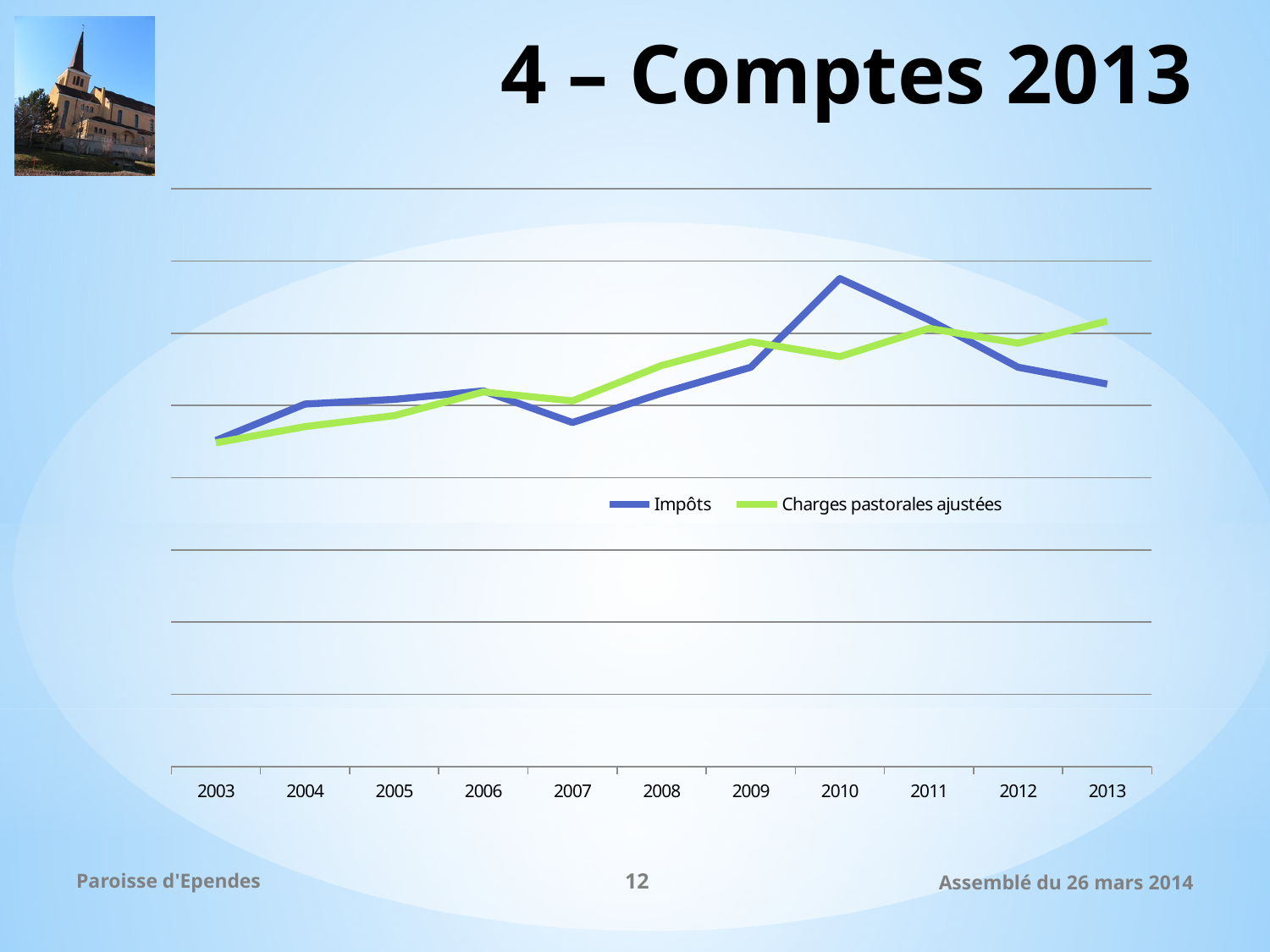
In which year is the Impôts series at its lowest? 2003 How many years are shown on the x axis? 11 In which year does the Charges pastorales ajustées series reach its highest value? 2013 In 2013, which series is higher: Impôts or Charges pastorales ajustées? Charges pastorales ajustées In which year does the Impôts series reach its highest value? 2010 Which colour is used for the Charges pastorales ajustées series? green Does the Impôts series rise or fall between 2010 and 2013? fall In 2007, which series is higher: Impôts or Charges pastorales ajustées? Charges pastorales ajustées In 2010, which series is higher: Impôts or Charges pastorales ajustées? Impôts In which year is the Charges pastorales ajustées series at its lowest? 2003 What kind of chart is shown on the slide? line chart How many series does the legend list? 2